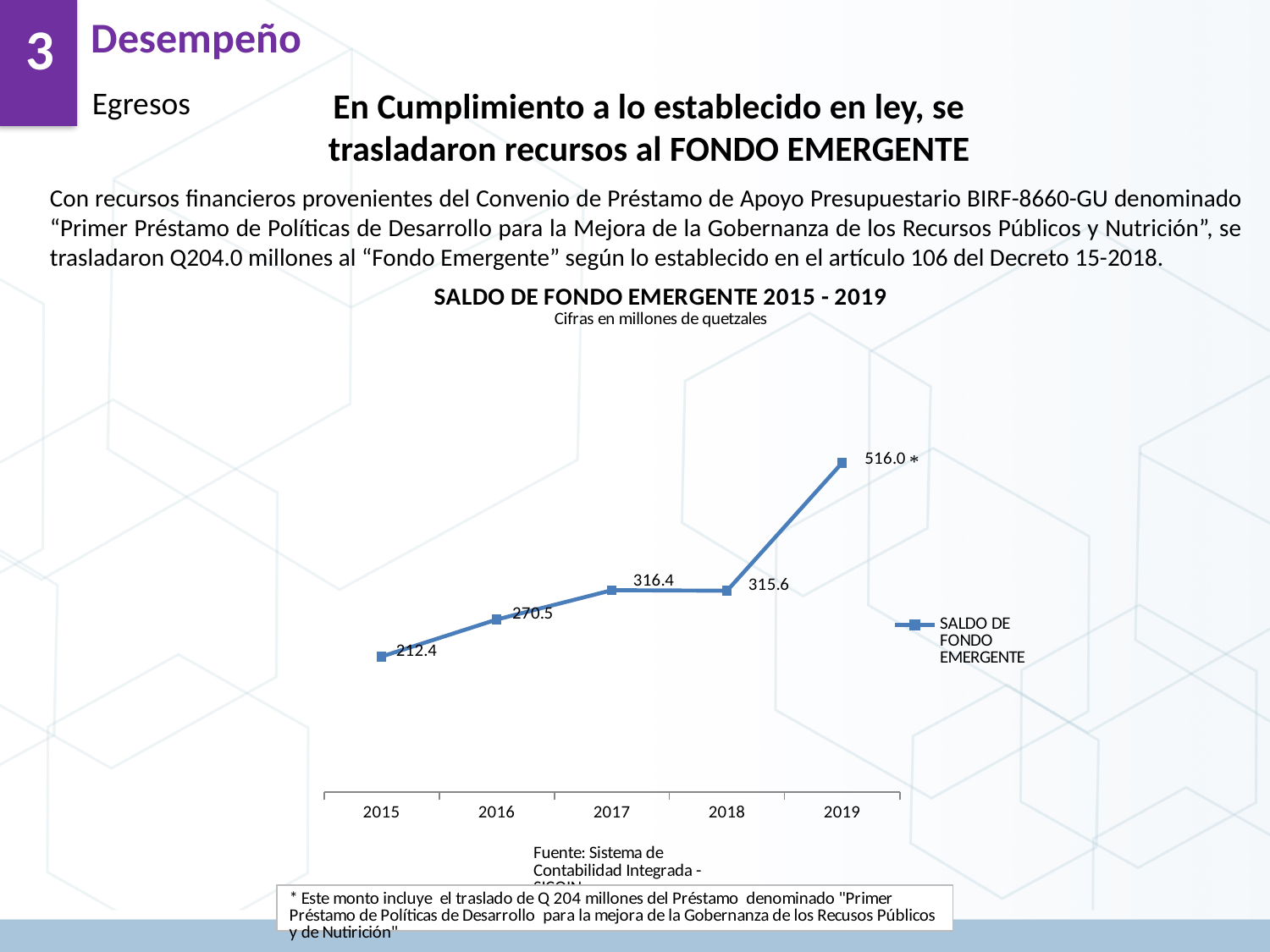
What unit is stated in the subtitle of the SALDO DE FONDO EMERGENTE chart? Cifras en millones de quetzales What is the value for 2019 in the SALDO DE FONDO EMERGENTE chart? 516.0 What is the value for 2015 in the SALDO DE FONDO EMERGENTE chart? 212.4 How many series does the legend of the SALDO DE FONDO EMERGENTE chart list? 1 What is the value for 2017 in the SALDO DE FONDO EMERGENTE chart? 316.4 How many years are plotted in the SALDO DE FONDO EMERGENTE chart? 5 What is the difference between the 2016 and 2015 values in the SALDO DE FONDO EMERGENTE chart? 58.1 What kind of chart is the SALDO DE FONDO EMERGENTE chart? Line chart Which year has the lowest value in the SALDO DE FONDO EMERGENTE chart? 2015 Which year has the highest value in the SALDO DE FONDO EMERGENTE chart? 2019 What is the difference between the 2019 and 2018 values in the SALDO DE FONDO EMERGENTE chart? 200.4 Which is larger in the SALDO DE FONDO EMERGENTE chart, the value for 2016 or the value for 2018? 2018